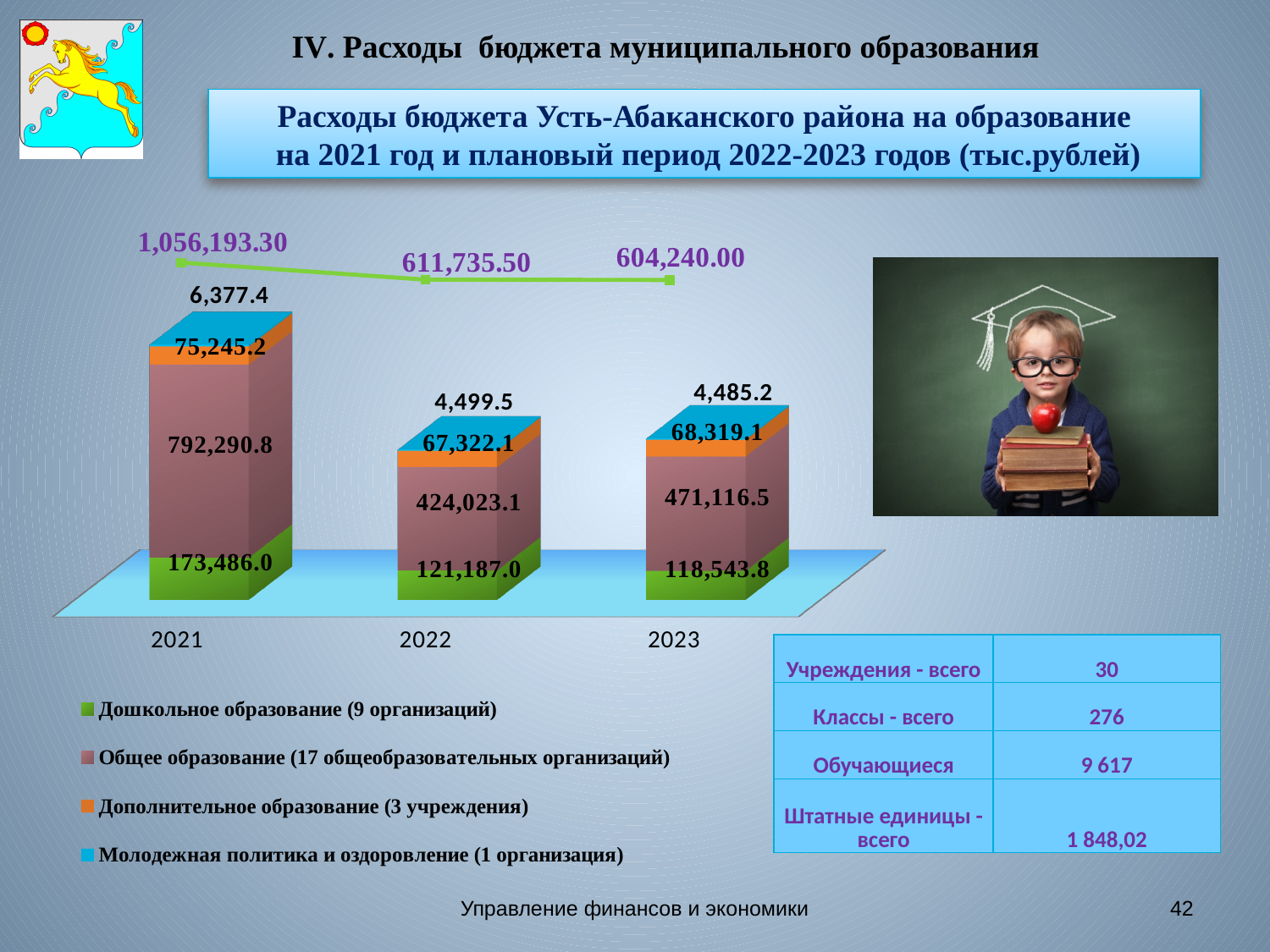
What total value is shown on the line for 2021? 1,056,193.30 What is the value for Молодежная политика и оздоровление in 2022? 4,499.5 What is the difference between the Молодежная политика и оздоровление values for 2021 and 2023? 1,892.2 What is the value for Общее образование in 2021? 792,290.8 In which year is the value for Общее образование the highest? 2021 How many years are shown on the x axis of the chart? 3 Do the total values shown on the line rise or fall from 2021 to 2023? fall How many series does the chart legend list? 4 In which year is the value for Дошкольное образование the lowest? 2023 What is the difference between the Дополнительное образование values for 2023 and 2022? 997.0 Which year has the larger value for Дошкольное образование, 2021 or 2022? 2021 What is the value for Дошкольное образование in 2023? 118,543.8